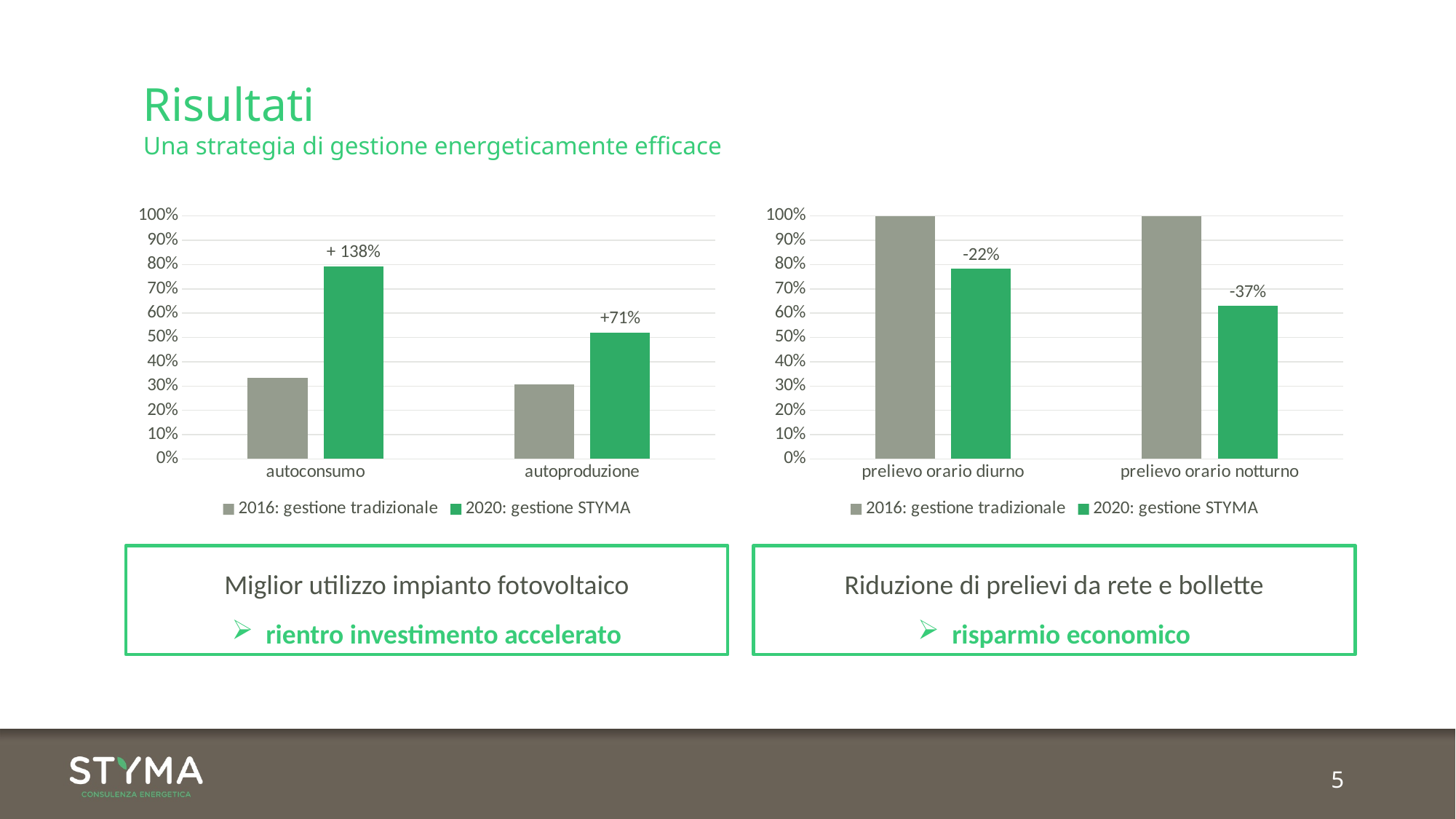
On the right chart, what change is printed above the 2020: gestione STYMA bar for prelievo orario diurno? -22% On the right chart, what change is printed above the 2020: gestione STYMA bar for prelievo orario notturno? -37% On the left chart, is the 2016: gestione tradizionale value for autoproduzione greater or less than 40%? less On the left chart, what change is printed above the 2020: gestione STYMA bar for autoconsumo? + 138% On the right chart, what is the value of the 2016: gestione tradizionale bar for prelievo orario diurno? 100% On the left chart, what change is printed above the 2020: gestione STYMA bar for autoproduzione? +71% On the right chart, is the 2020: gestione STYMA value for prelievo orario notturno greater or less than 70%? less On the left chart, is the 2020: gestione STYMA value for autoconsumo greater or less than 70%? greater On the left chart, which category has the higher 2020: gestione STYMA bar, autoconsumo or autoproduzione? autoconsumo How many series does the legend of the left chart list? 2 On the right chart, which category has the lower 2020: gestione STYMA bar? prelievo orario notturno What kind of chart is the right chart? bar chart